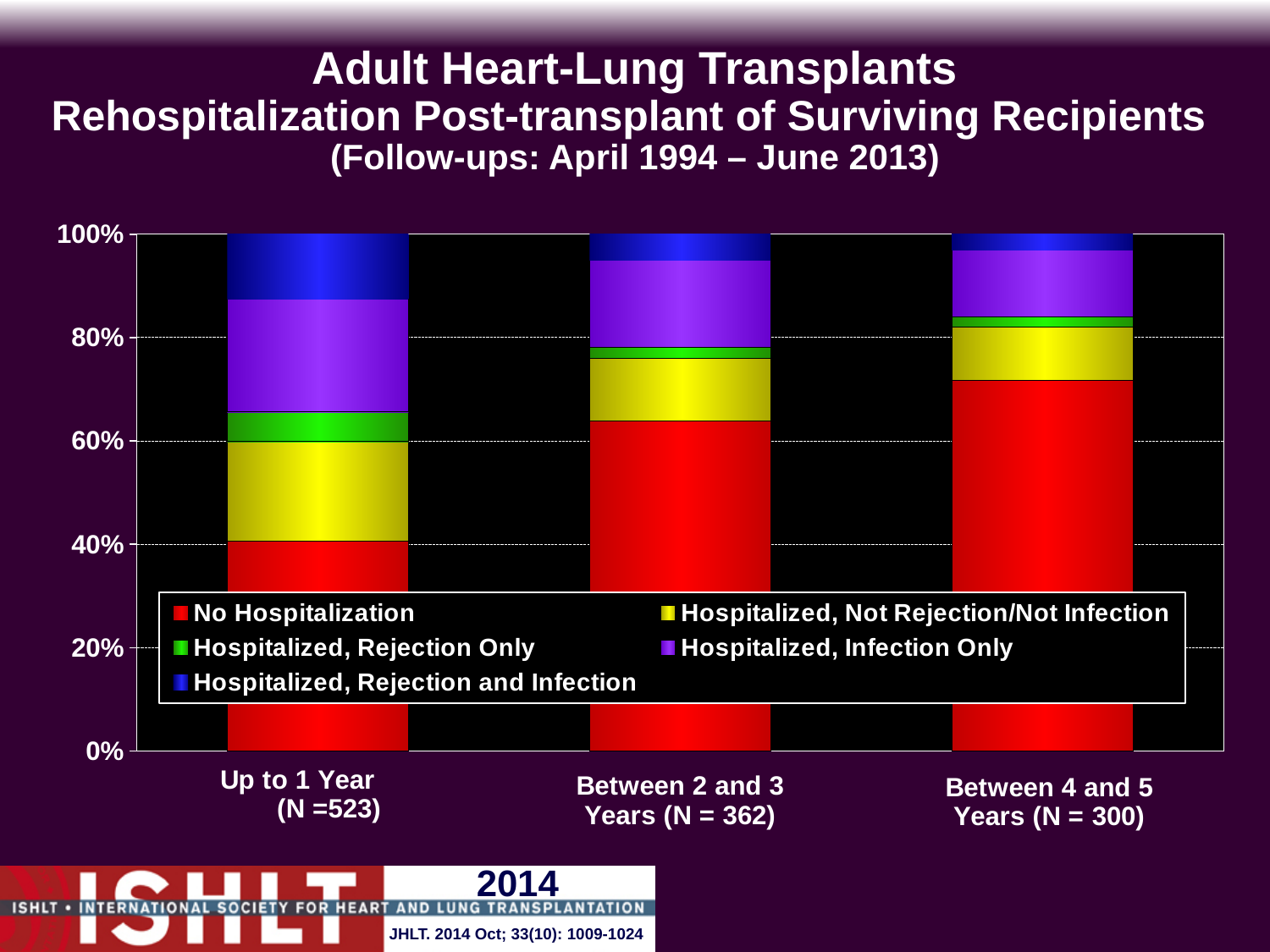
What kind of chart is shown on the slide? Stacked bar chart What is the total of each stacked bar? 100% Is the Hospitalized, Rejection and Infection share for Up to 1 Year greater or less than 20%? less Which category has the largest No Hospitalization segment? Between 4 and 5 Years (N = 300) How many follow-up categories are shown on the x axis? 3 What is the N for the Between 2 and 3 Years category? 362 Is the No Hospitalization value for Up to 1 Year greater or less than 60%? less Which is larger: the No Hospitalization share for Up to 1 Year or for Between 4 and 5 Years? Between 4 and 5 Years Is the No Hospitalization value for Between 2 and 3 Years greater or less than 60%? greater How many series does the legend list? 5 Does the No Hospitalization share rise or fall from Up to 1 Year to Between 4 and 5 Years? Rise Which category has the smallest No Hospitalization segment? Up to 1 Year (N =523)